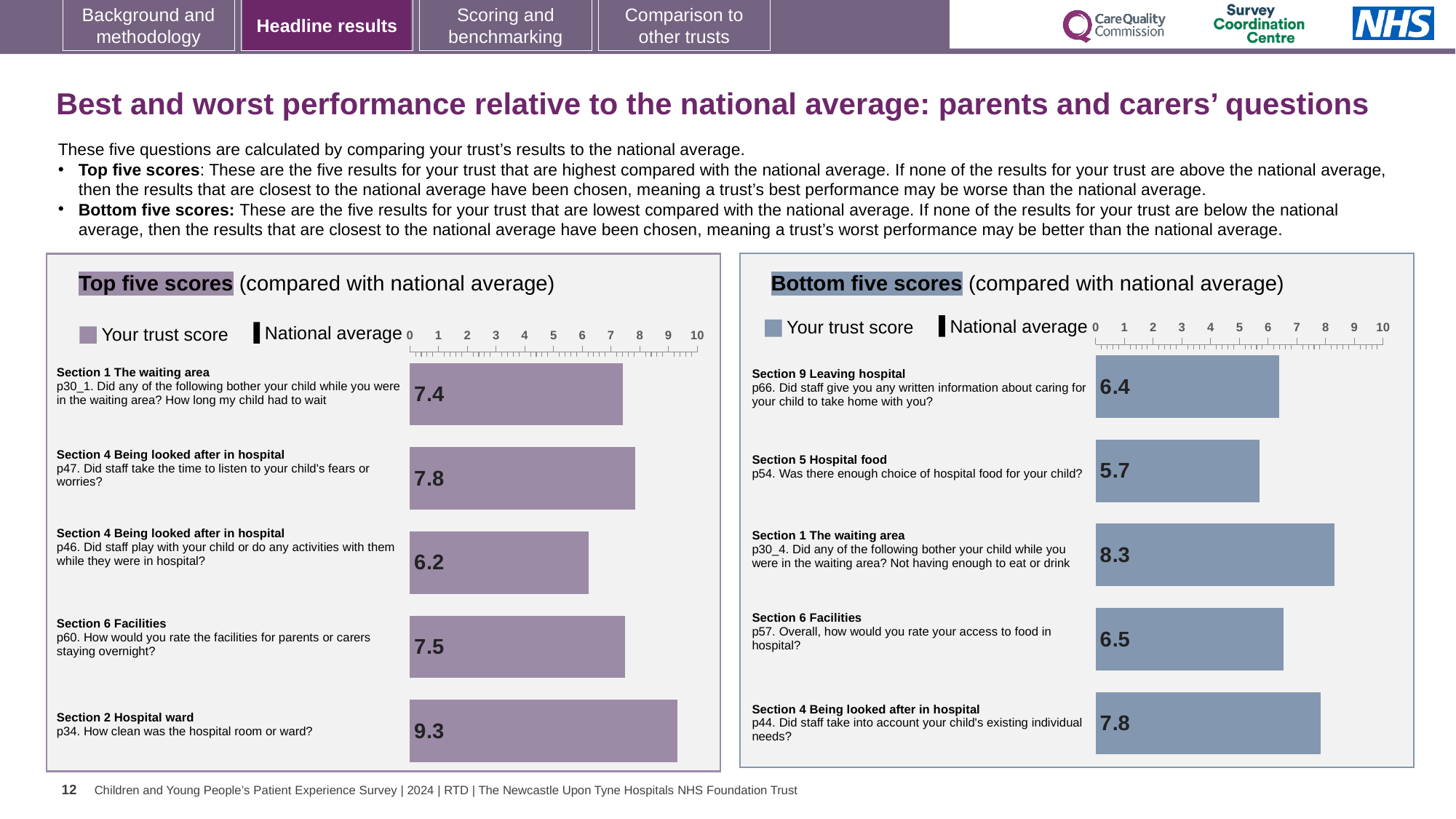
In the Bottom five scores chart, which question has the lowest trust score? p54. Was there enough choice of hospital food for your child? In the Top five scores chart, what is the trust score for p34 'How clean was the hospital room or ward?' 9.3 In the Bottom five scores chart, which has the larger trust score: p44 (child's existing individual needs) or p66 (written information to take home)? p44 (child's existing individual needs) In the Top five scores chart, what is the difference between the trust scores for p34 (hospital room or ward cleanliness) and p46 (staff playing with your child)? 3.1 In the Bottom five scores chart, what is the trust score for p54 'Was there enough choice of hospital food for your child?' 5.7 In the Top five scores chart, which question has the highest trust score? p34. How clean was the hospital room or ward? What type of chart is the Bottom five scores chart? Bar chart In the Top five scores chart, what is the trust score for p46 'Did staff play with your child or do any activities with them while they were in hospital?' 6.2 In the Bottom five scores chart, which question has the highest trust score? p30_4. Did any of the following bother your child while you were in the waiting area? Not having enough to eat or drink In the Top five scores chart, which question has the lowest trust score? p46. Did staff play with your child or do any activities with them while they were in hospital? How many bars are shown in the Top five scores chart? 5 In the Bottom five scores chart, what is the difference between the trust scores for p30_4 (not having enough to eat or drink) and p54 (choice of hospital food)? 2.6